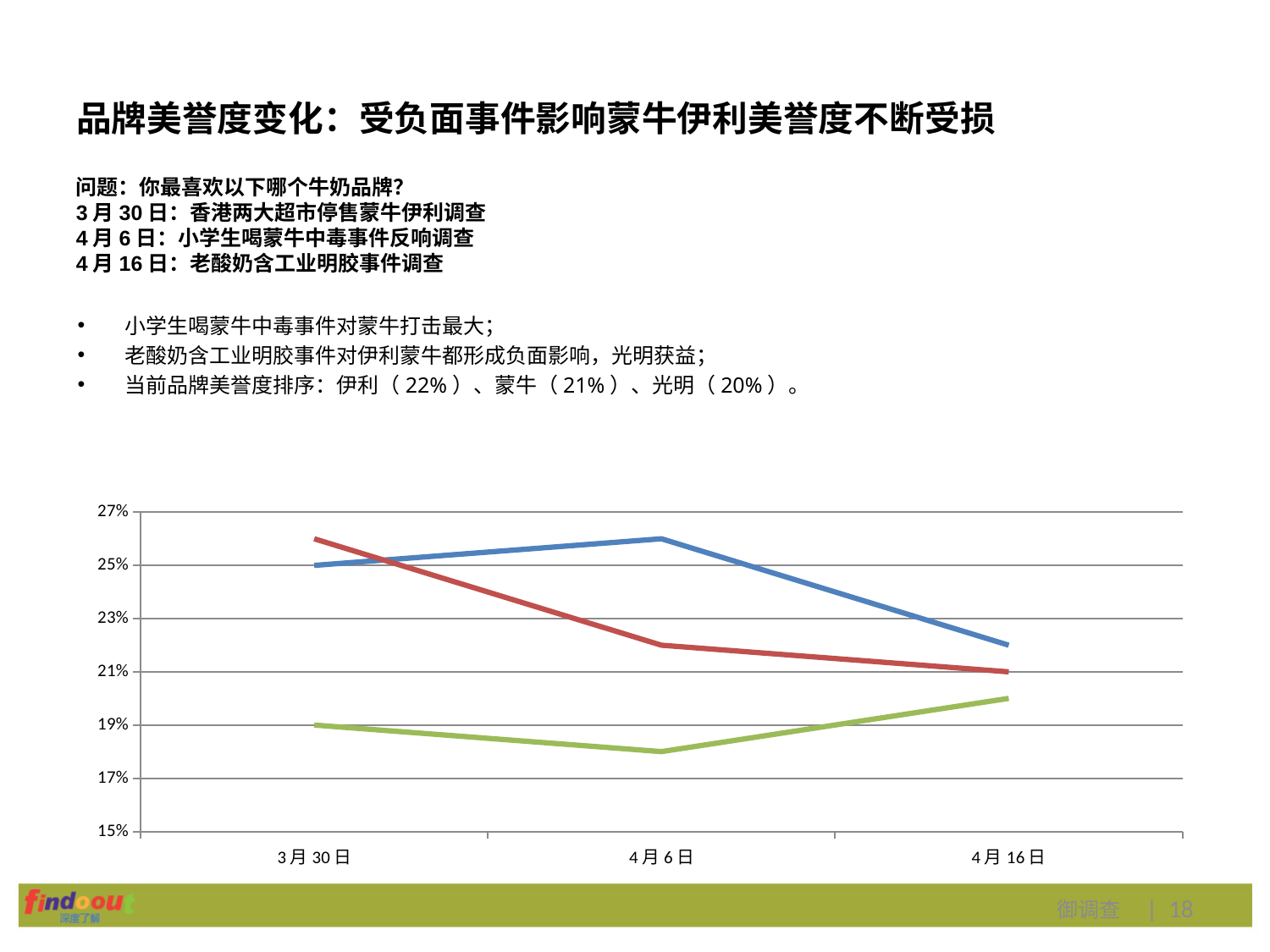
What is the value of the blue line at 3月30日? 25% What is the difference between the blue line and the green line at 3月30日? 6% How many lines are plotted on the chart? 3 What type of chart is shown on the slide? line chart What is the value of the red line at 4月16日? 21% Is the value of the green line at 4月6日 greater or less than 19%? less How many dates are shown on the x axis of the chart? 3 Does the red line rise or fall from 3月30日 to 4月16日? fall At 4月6日, which line is higher, the blue line or the red line? blue line Is the value of the blue line at 4月6日 greater or less than 25%? greater Is the value of the red line at 4月6日 greater or less than 23%? less What is the value of the green line at 3月30日? 19%